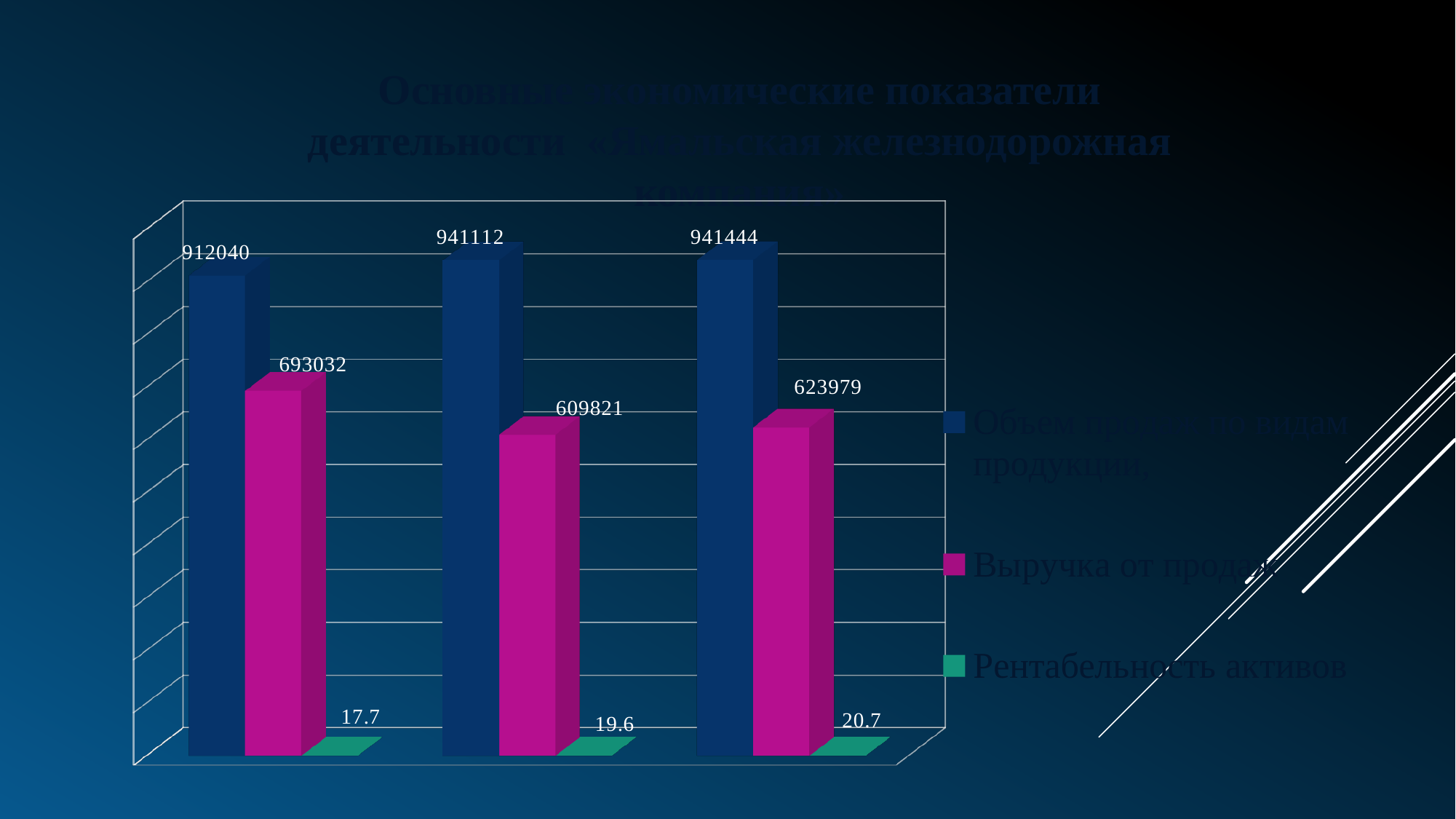
Which group of bars has the highest value for Выручка от продаж? the first group How many groups of bars are shown in the chart? 3 What is the value of Рентабельность активов for the third group of bars? 20.7 Which group of bars has the lowest value for Рентабельность активов? the first group How many series does the legend list? 3 What is the difference between the Выручка от продаж values of the third and second groups? 14158 What is the value of Выручка от продаж for the second group of bars? 609821 What is the value of the dark blue bar in the second group? 941112 Which is larger: Выручка от продаж in the first group or in the third group? the first group Do the values of Рентабельность активов rise or fall from the first group to the third? rise What is the difference between the dark blue bar values of the third and second groups? 332 What is the value of Выручка от продаж for the first group of bars? 693032